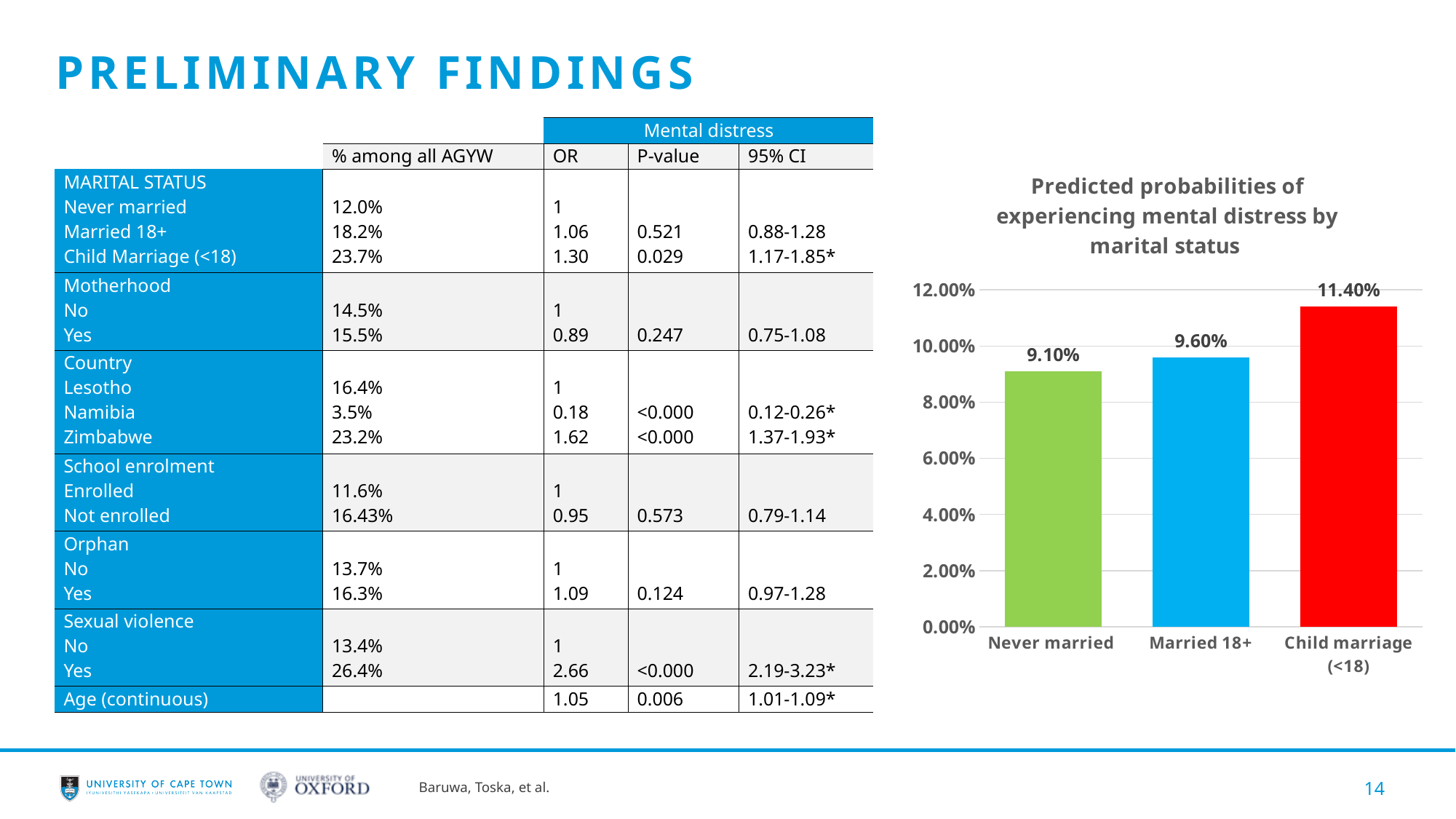
Is the predicted probability for Child marriage (<18) greater or less than 10.00%? greater What is the predicted probability of experiencing mental distress for Child marriage (<18)? 11.40% What is the predicted probability of experiencing mental distress for Married 18+? 9.60% Do the predicted probabilities rise or fall from Never married to Child marriage (<18)? Rise What is the predicted probability of experiencing mental distress for Never married? 9.10% What kind of chart is used to show predicted probabilities by marital status? Bar chart Which has a higher predicted probability of mental distress, Married 18+ or Child marriage (<18)? Child marriage (<18) What is the difference in predicted probability between Married 18+ and Never married? 0.50% Which marital status category has the lowest predicted probability of mental distress? Never married Which marital status category has the highest predicted probability of mental distress? Child marriage (<18) How many marital status categories are shown in the chart? 3 What is the difference in predicted probability between Child marriage (<18) and Never married? 2.30%